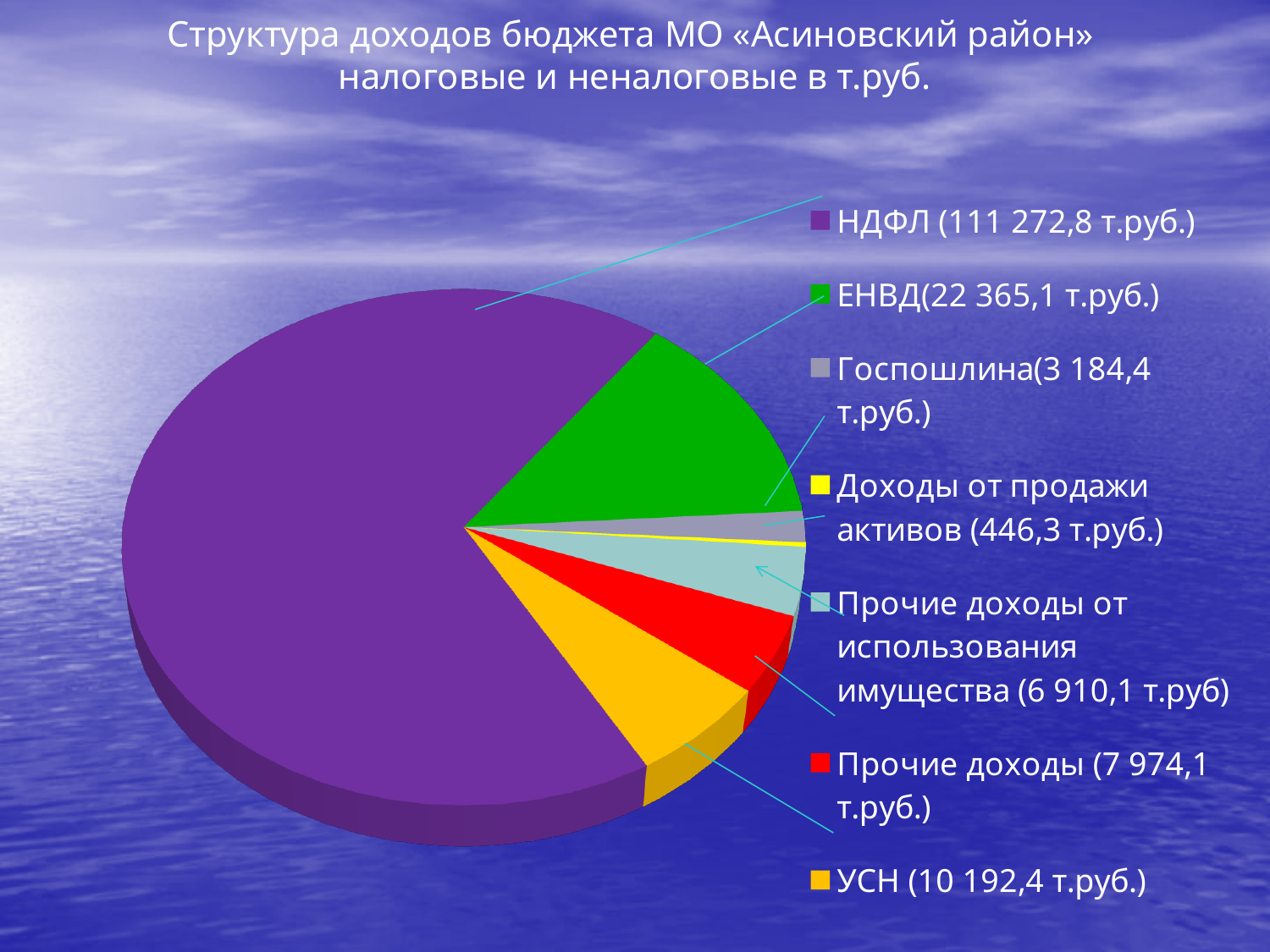
How many categories does the pie chart show? 7 What is the value for НДФЛ? 111 272,8 т.руб. Which is larger, УСН or Прочие доходы? УСН What is the value for Госпошлина? 3 184,4 т.руб. What is the value for УСН? 10 192,4 т.руб. What is the value for ЕНВД? 22 365,1 т.руб. Which category has the largest value? НДФЛ What kind of chart is shown on the slide? Pie chart What is the value for Прочие доходы от использования имущества? 6 910,1 т.руб Which category has the smallest value? Доходы от продажи активов What is the difference between the values for НДФЛ and ЕНВД? 88 907,7 т.руб. What colour is the НДФЛ slice? Purple